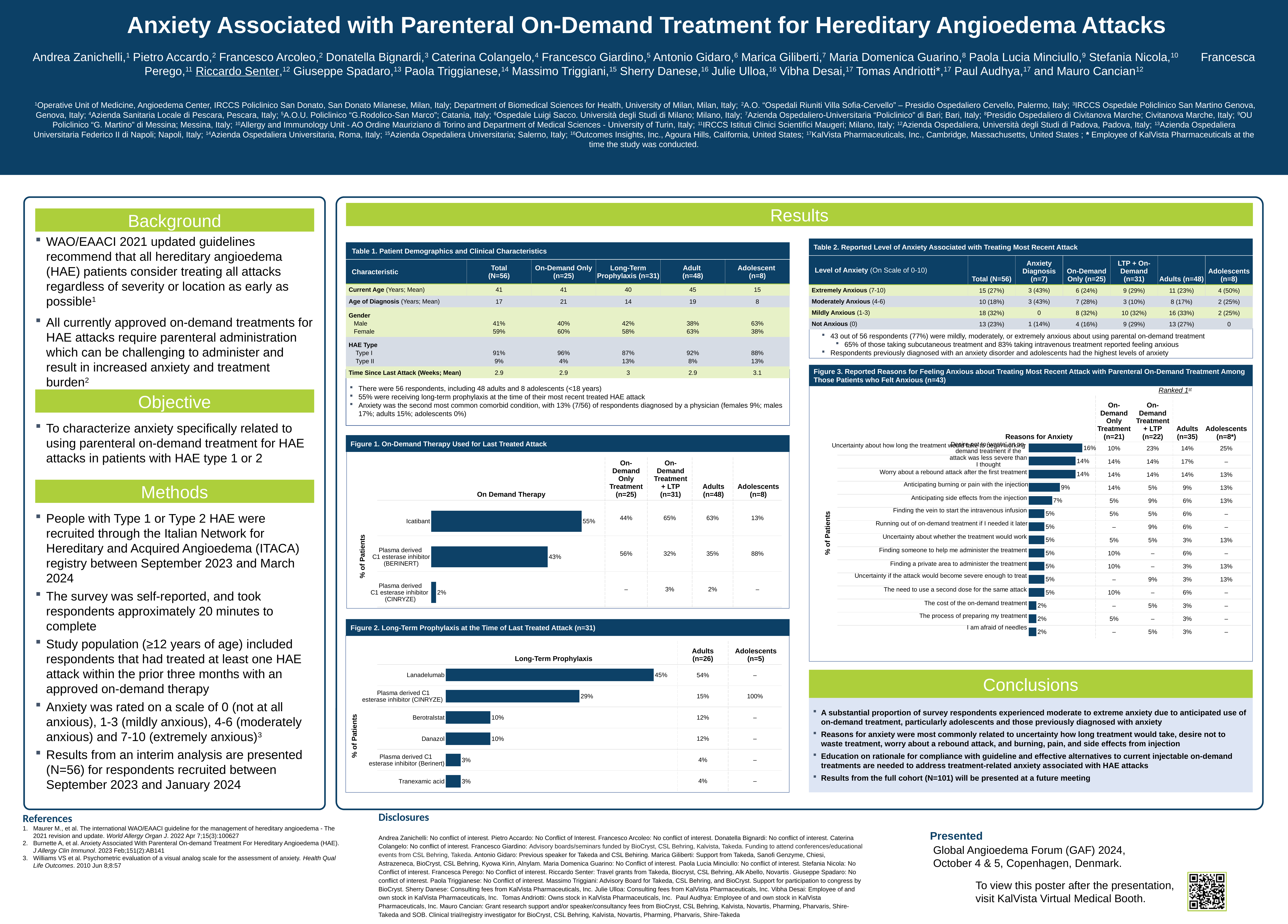
In Figure 1 (On-Demand Therapy Used for Last Treated Attack), how many on-demand therapies are plotted? 3 What kind of chart is Figure 2 (Long-Term Prophylaxis at the Time of Last Treated Attack)? Bar chart In Figure 2 (Long-Term Prophylaxis at the Time of Last Treated Attack), which is larger: the value for Plasma derived C1 esterase inhibitor (CINRYZE) or the value for Berotralstat? Plasma derived C1 esterase inhibitor (CINRYZE) In Figure 2 (Long-Term Prophylaxis at the Time of Last Treated Attack), which long-term prophylaxis has the highest percentage of patients? Lanadelumab In Figure 3 (Reported Reasons for Feeling Anxious), what is the difference in percentage points between 'Anticipating burning or pain with the injection' and 'Anticipating side effects from the injection'? 2 In Figure 3 (Reported Reasons for Feeling Anxious), what percentage of patients reported 'Worry about a rebound attack after the first treatment'? 14% In Figure 2 (Long-Term Prophylaxis at the Time of Last Treated Attack), what percentage of patients used Lanadelumab? 45% In Figure 1 (On-Demand Therapy Used for Last Treated Attack), what percentage of patients used Icatibant? 55% In Figure 1 (On-Demand Therapy Used for Last Treated Attack), what is the difference in percentage points between Icatibant and Plasma derived C1 esterase inhibitor (BERINERT)? 12 In Figure 1 (On-Demand Therapy Used for Last Treated Attack), which on-demand therapy has the lowest percentage of patients? Plasma derived C1 esterase inhibitor (CINRYZE) In Figure 2 (Long-Term Prophylaxis at the Time of Last Treated Attack), how many long-term prophylaxis categories are plotted? 6 In Figure 3 (Reported Reasons for Feeling Anxious), which reason for anxiety has the highest percentage of patients? Uncertainty about how long the treatment would take to begin working